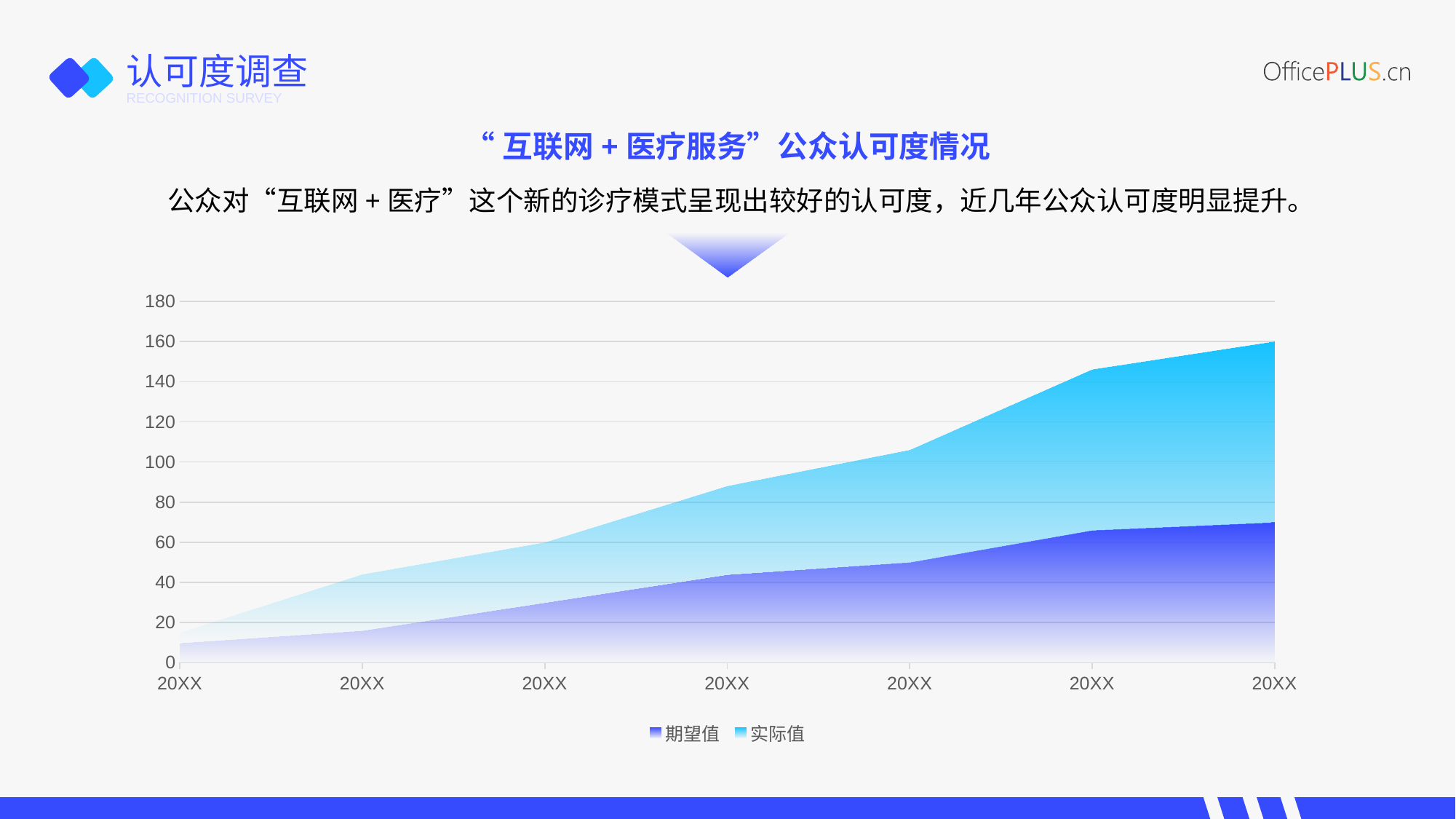
Do the values of 期望值 rise or fall from left to right along the x axis? rise What kind of chart is shown on the slide? area chart How many series does the chart legend list? 2 Is the value of 期望值 at the last point on the x axis greater or less than 60? greater Do the values of 实际值 rise or fall from left to right along the x axis? rise Is the value of 实际值 at the first point on the x axis greater or less than 40? less How many points are plotted along the x axis of the chart? 7 What are the two series named in the chart legend? 期望值 and 实际值 What is the title of the chart on the slide? “互联网＋医疗服务”公众认可度情况 At the last point on the x axis, which series has the larger value, 期望值 or 实际值? 实际值